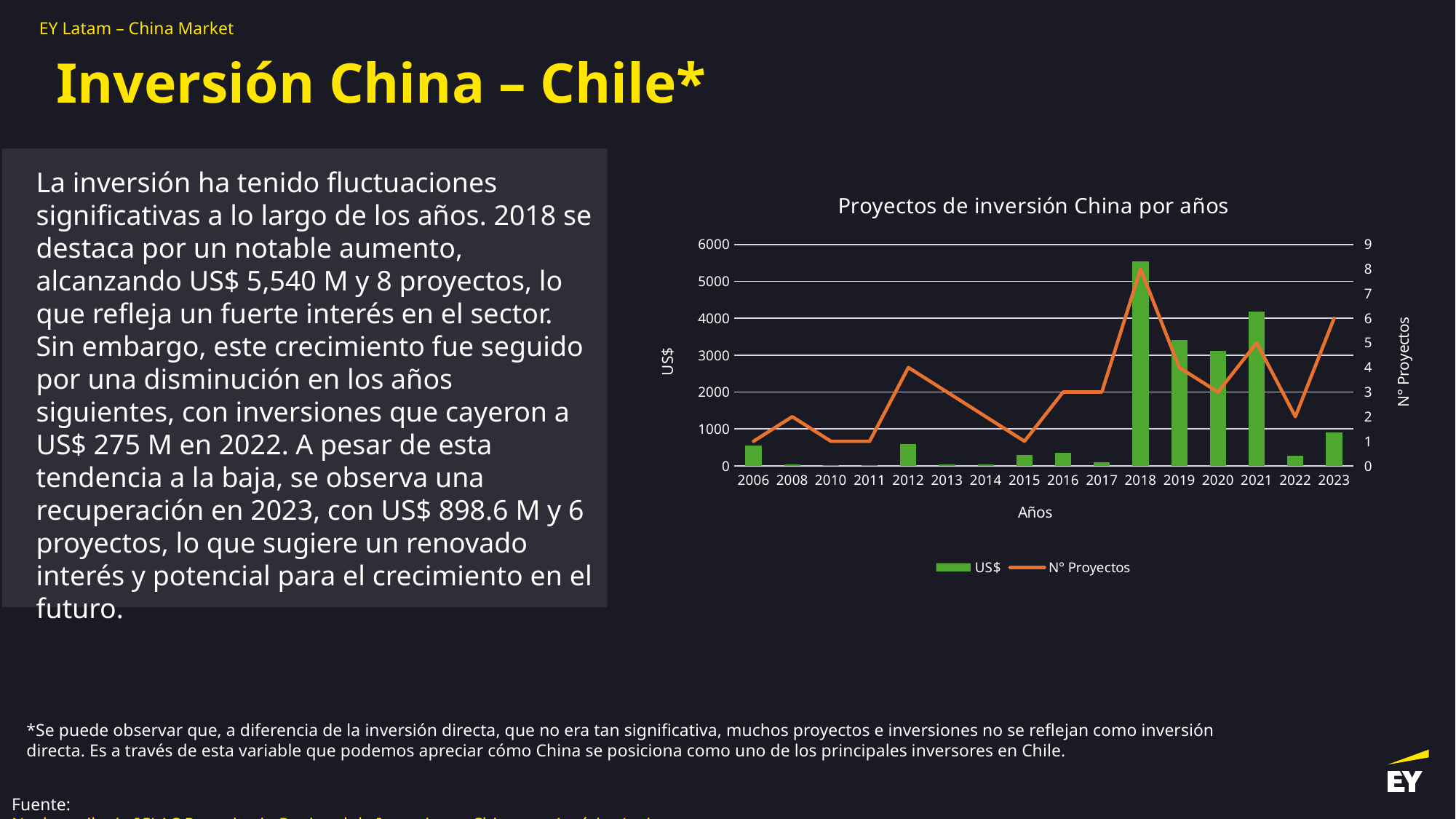
What is the title of the chart? Proyectos de inversión China por años Which year has a larger US$ bar, 2021 or 2019? 2021 How many years are shown on the x axis of the chart? 16 Which series is drawn as an orange line in the chart? N° Proyectos Is the US$ value for 2022 greater or less than 1000? less What is the N° Proyectos value for 2018? 8 Is the US$ value for 2018 greater or less than 5000? greater What type of chart is shown on the slide? Combination bar and line chart How many series does the chart legend list? 2 In which year does the N° Proyectos line reach its highest point? 2018 Which year has the highest US$ bar in the chart? 2018 What is the N° Proyectos value for 2023? 6